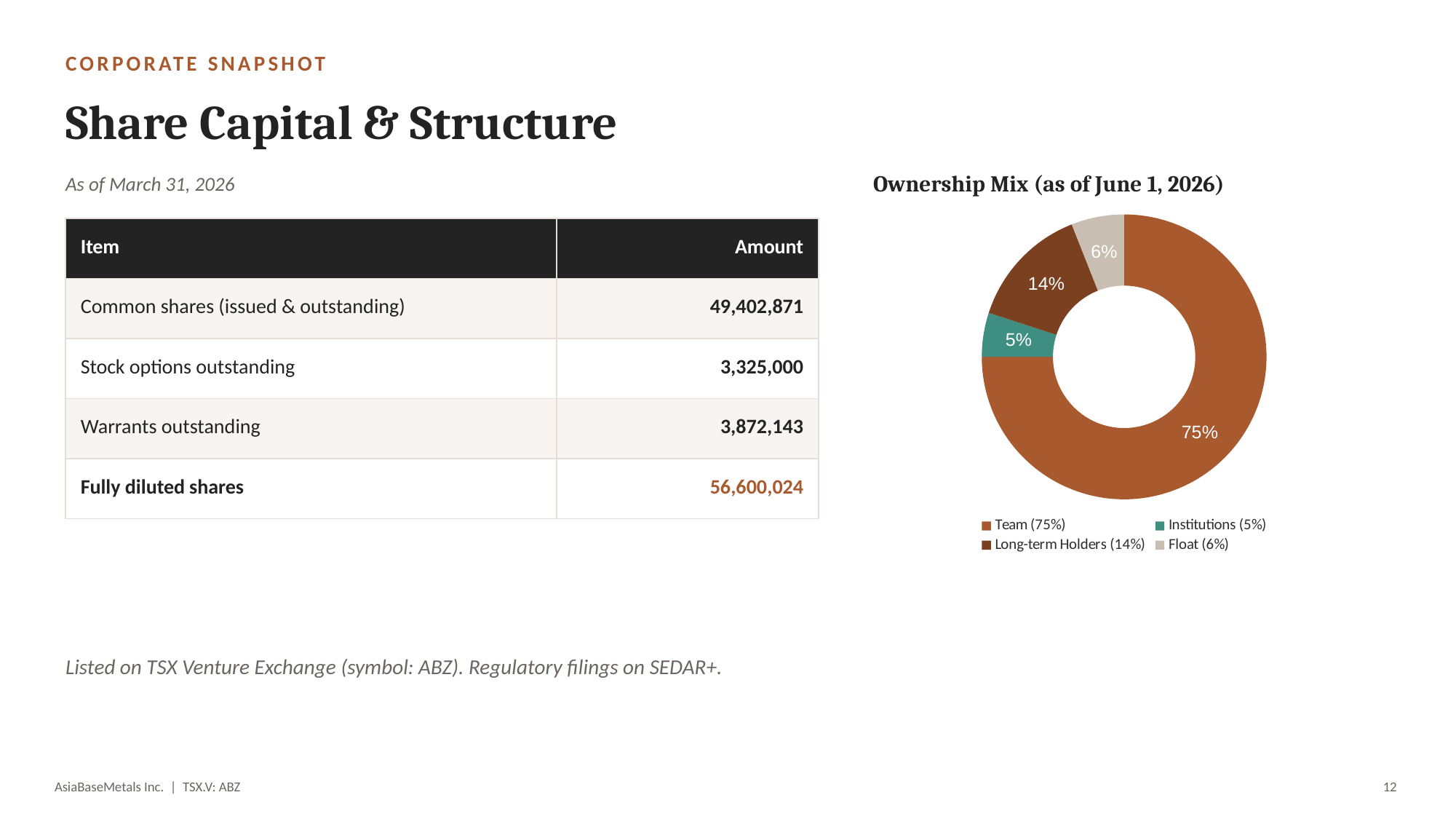
In the Ownership Mix chart, what colour is the Institutions slice? Teal (green) How many categories does the Ownership Mix chart show? 4 What share of the Ownership Mix chart do Institutions hold? 5% Which category has the largest share in the Ownership Mix chart? Team What share of the Ownership Mix chart is Float? 6% In the Ownership Mix chart, how many percentage points larger is the Team share than the Long-term Holders share? 61 What share of the Ownership Mix chart does Team hold? 75% In the Ownership Mix chart, which is larger: Float or Institutions? Float Which category has the smallest share in the Ownership Mix chart? Institutions What share of the Ownership Mix chart do Long-term Holders hold? 14% What kind of chart is the Ownership Mix chart? Doughnut (pie) chart What is the title of the chart on the slide? Ownership Mix (as of June 1, 2026)